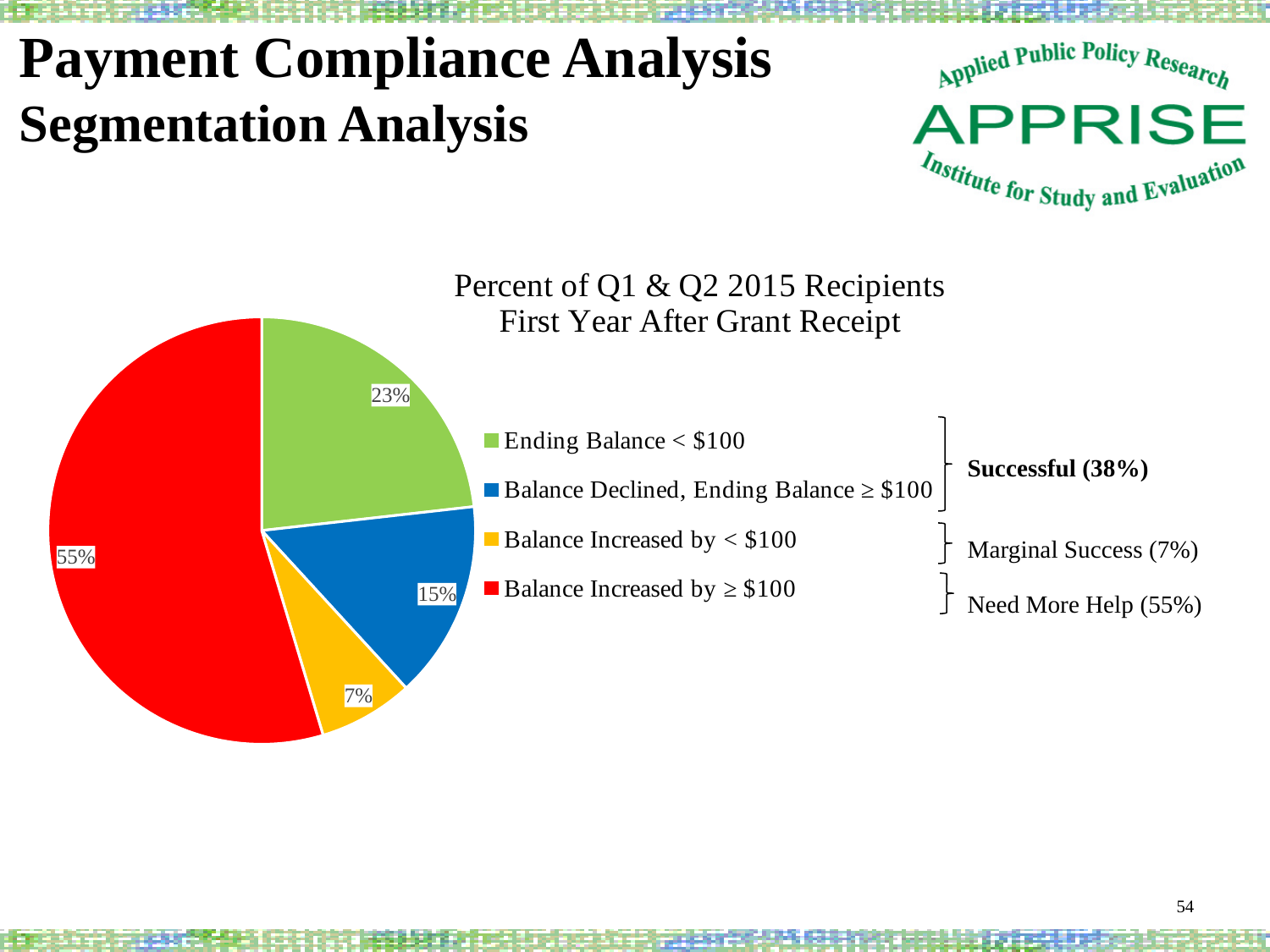
How many slices does the pie chart have? 4 Which category has the smallest share of the pie? Balance Increased by < $100 What percentage of recipients had Balance Increased by < $100? 7% What kind of chart is shown on the slide? pie chart What colour is the slice for Balance Increased by ≥ $100? red Which is larger: the share for Ending Balance < $100 or the share for Balance Increased by < $100? Ending Balance < $100 What percentage of recipients had Balance Increased by ≥ $100? 55% What is the difference in percentage points between Ending Balance < $100 and Balance Declined, Ending Balance ≥ $100? 8 percentage points Which category has the largest share of the pie? Balance Increased by ≥ $100 What is the chart's title? Percent of Q1 & Q2 2015 Recipients First Year After Grant Receipt What percentage of recipients had an Ending Balance < $100? 23% What percentage of recipients had Balance Declined, Ending Balance ≥ $100? 15%